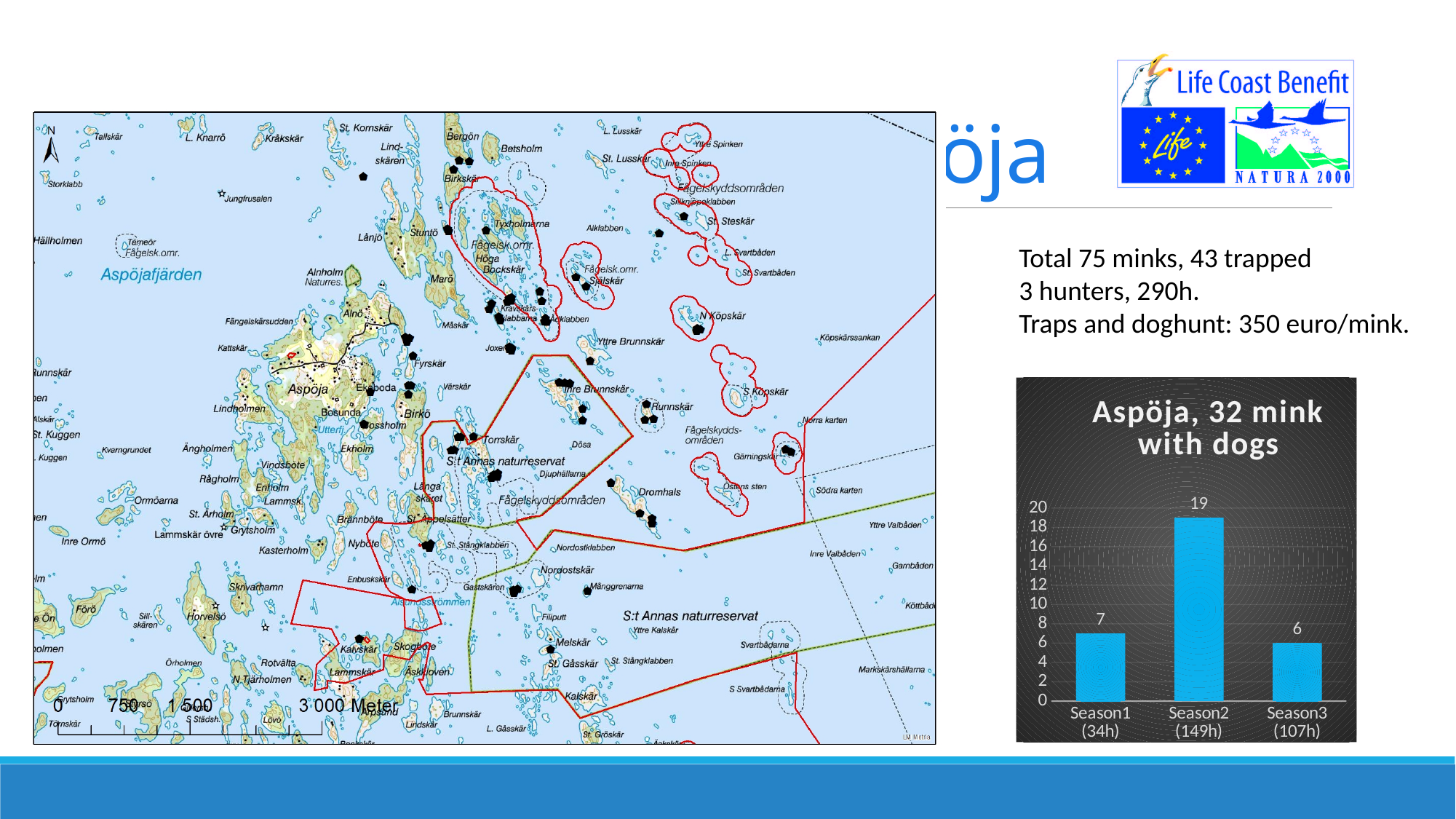
Which season has the lowest value in the chart 'Aspöja, 32 mink with dogs'? Season3 (107h) What is the value for Season3 (107h) in the chart 'Aspöja, 32 mink with dogs'? 6 How many categories are shown in the chart 'Aspöja, 32 mink with dogs'? 3 What is the total of the three values shown in the chart 'Aspöja, 32 mink with dogs'? 32 What kind of chart is 'Aspöja, 32 mink with dogs'? bar chart What is the title of the chart on the slide? Aspöja, 32 mink with dogs Is the value for Season2 (149h) greater or less than 10 in the chart 'Aspöja, 32 mink with dogs'? greater What is the difference between the values for Season2 (149h) and Season1 (34h) in the chart 'Aspöja, 32 mink with dogs'? 12 What is the value for Season2 (149h) in the chart 'Aspöja, 32 mink with dogs'? 19 Which season has the highest value in the chart 'Aspöja, 32 mink with dogs'? Season2 (149h) What is the difference between the values for Season1 (34h) and Season3 (107h) in the chart 'Aspöja, 32 mink with dogs'? 1 What is the value for Season1 (34h) in the chart 'Aspöja, 32 mink with dogs'? 7